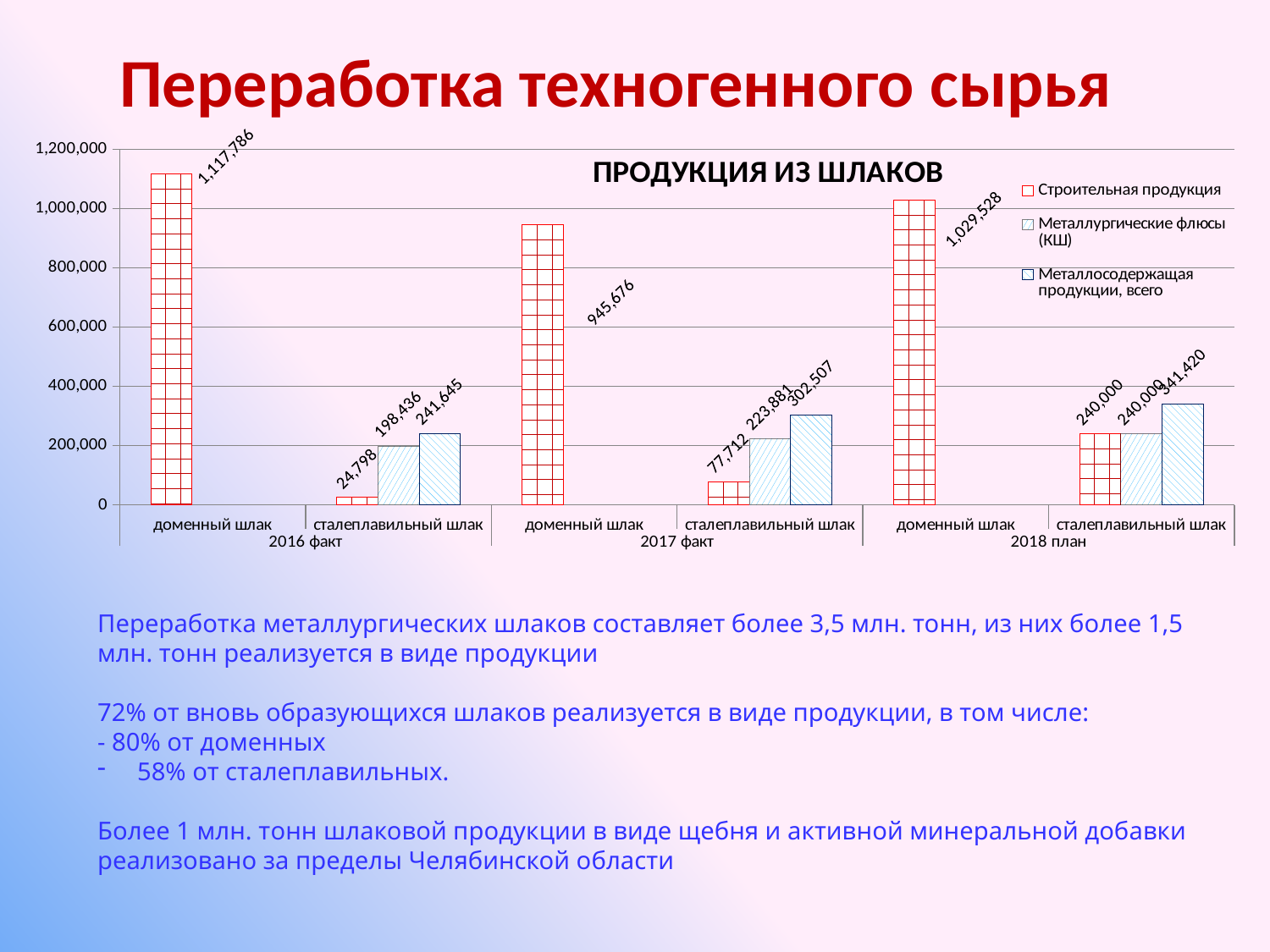
What is the title of the chart? ПРОДУКЦИЯ ИЗ ШЛАКОВ Which year has the highest value of Строительная продукция for доменный шлак? 2016 факт What is the value of Металлургические флюсы (КШ) for сталеплавильный шлак in 2016 факт? 198,436 What is the value of Строительная продукция for доменный шлак in 2016 факт? 1,117,786 What is the value of Строительная продукция for доменный шлак in 2017 факт? 945,676 How many series does the chart legend list? 3 Which is larger: Строительная продукция for сталеплавильный шлак in 2017 факт or in 2016 факт? 2017 факт What kind of chart is shown on the slide? bar chart What is the value of Металлосодержащая продукции, всего for сталеплавильный шлак in 2017 факт? 302,507 Is the value of Строительная продукция for доменный шлак in 2017 факт greater or less than 1,000,000? less What is the difference between Металлосодержащая продукции, всего for сталеплавильный шлак in 2018 план and in 2017 факт? 38,913 What is the value of Строительная продукция for доменный шлак in 2018 план? 1,029,528